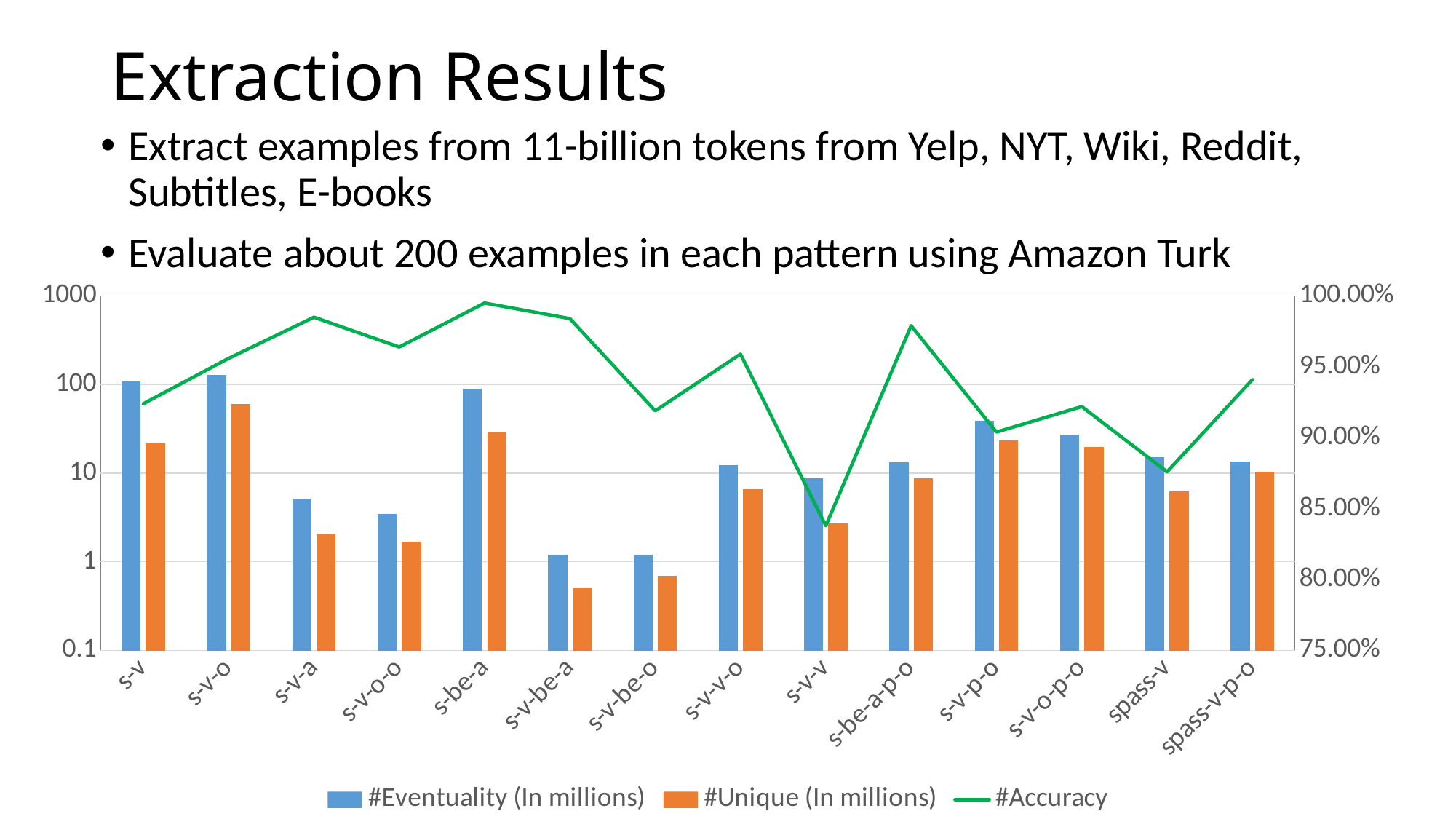
Is the #Unique (In millions) for s-v-be-a greater or less than 1? less What kind of chart is this? Bar chart with a line Is the #Unique (In millions) for s-v-p-o greater or less than 10? greater Is the #Accuracy for s-v-v greater or less than 85.00%? less Which pattern has the highest #Unique (In millions)? s-v-o How many series does the legend list? 3 Which series is drawn as a green line? #Accuracy Which has the larger #Eventuality (In millions), s-v-a or s-v-o-o? s-v-a Which pattern has the lowest #Accuracy? s-v-v How many patterns (categories) are shown on the x axis? 14 Which pattern has the highest #Accuracy? s-be-a